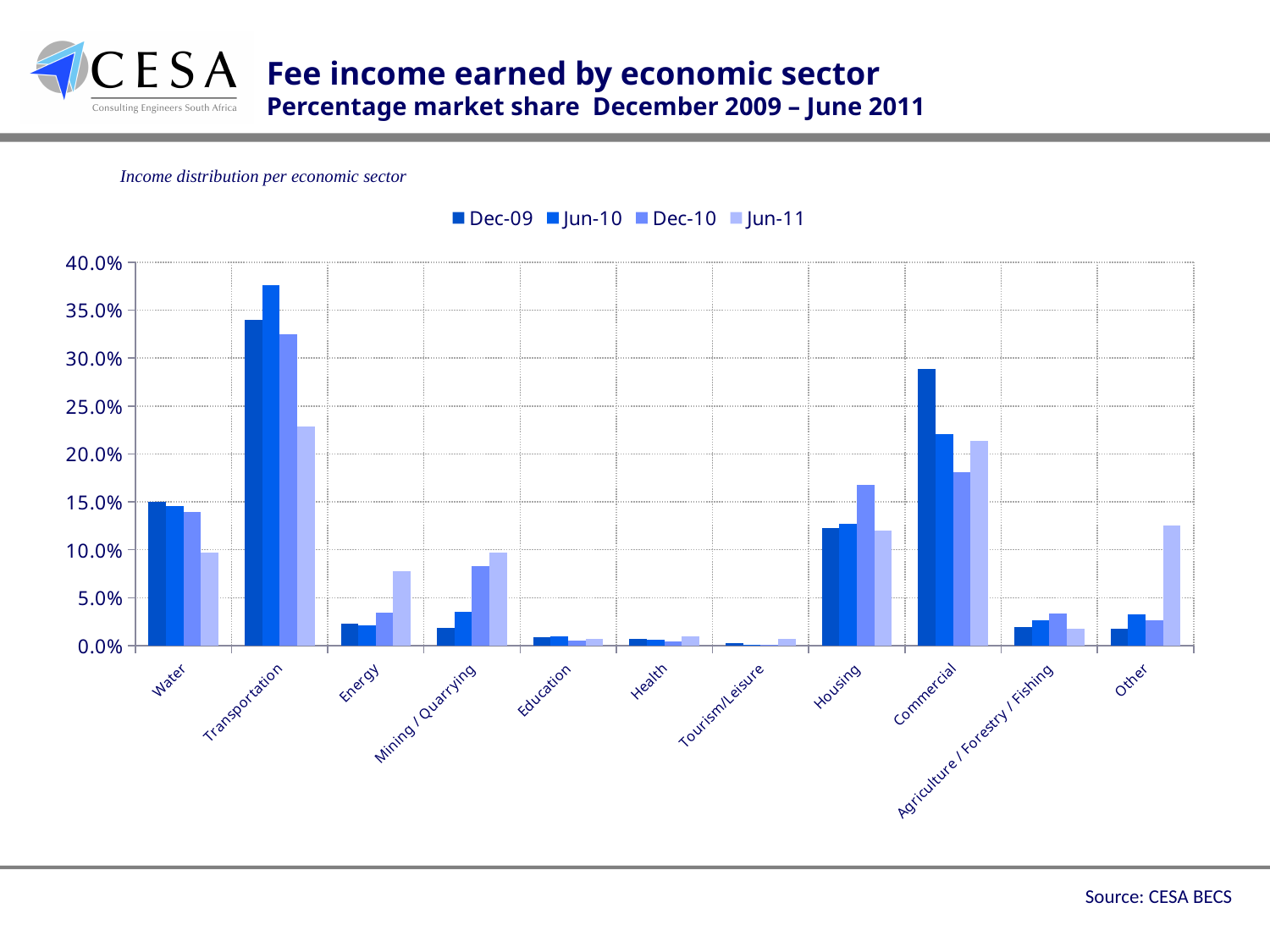
For Dec-09, which is larger: the value for Commercial or the value for Housing? Commercial Which economic sector has the lowest fee income share for Dec-09? Tourism/Leisure Is the Jun-10 value for Transportation greater or less than 35.0%? greater Is the Jun-11 value for Transportation greater or less than 25.0%? less Is the Dec-10 value for Housing greater or less than 15.0%? greater What kind of chart is shown on the slide? bar chart How many economic sector categories are shown on the x axis? 11 Do the values for Mining / Quarrying rise or fall from Dec-09 to Jun-11? rise How many series does the legend list? 4 Do the values for Water rise or fall from Dec-09 to Jun-11? fall Which economic sector has the highest fee income share for Jun-10? Transportation